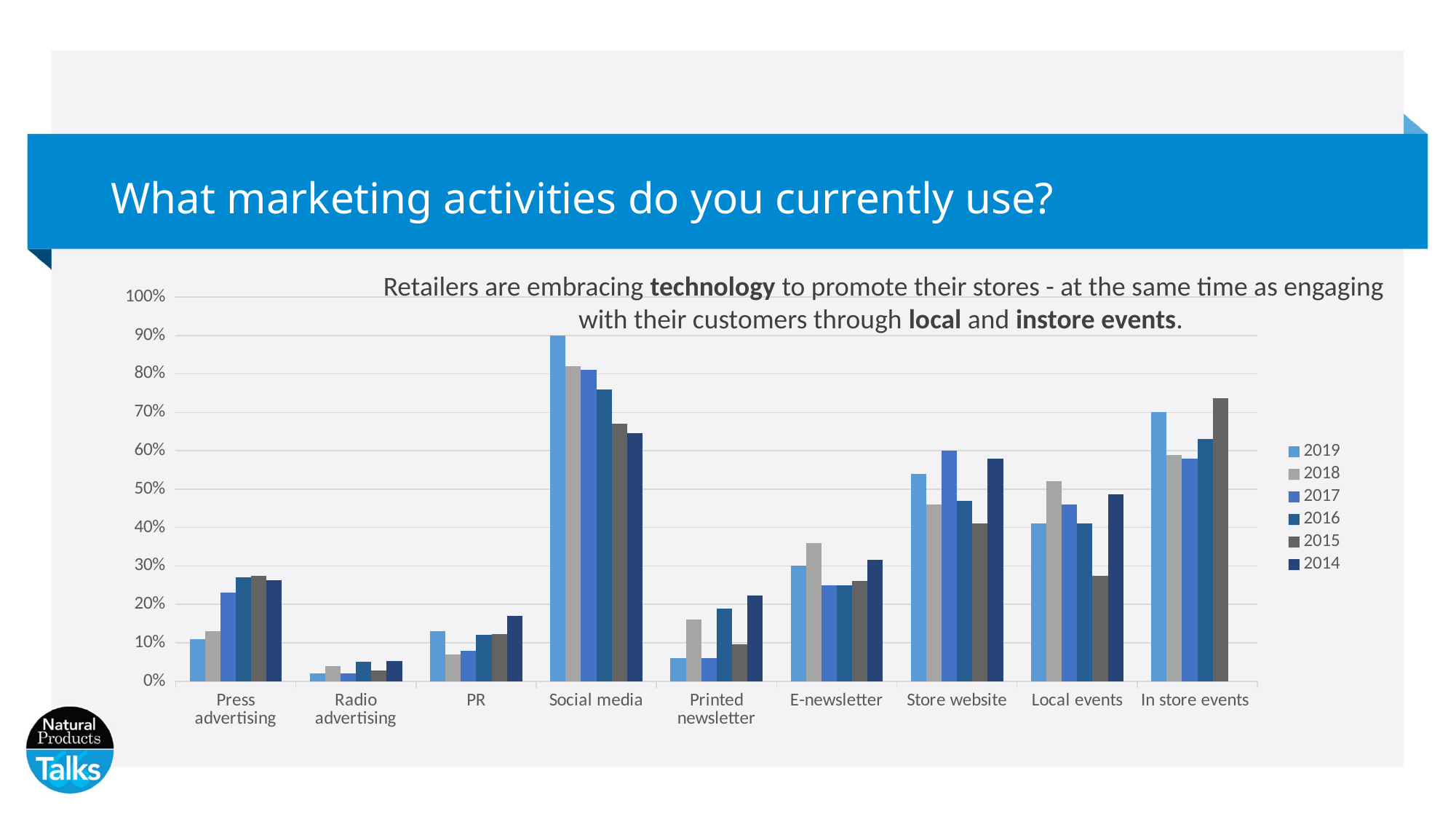
Which year is listed first in the legend? 2019 For Social media, did the value rise or fall from 2014 to 2019? rise What kind of chart is shown on the slide? bar chart Which marketing activity has the lowest value for 2019? Radio advertising Is the 2017 value for Store website greater or less than 50%? greater Is the 2019 value for Social media greater or less than 80%? greater Which marketing activity has the highest value for 2019? Social media Is the 2019 value for Press advertising greater or less than 20%? less How many marketing activity categories are shown on the x axis? 9 For Social media, which is larger: the 2019 value or the 2014 value? 2019 For Local events, which is larger: the 2018 value or the 2015 value? 2018 How many series does the legend list? 6